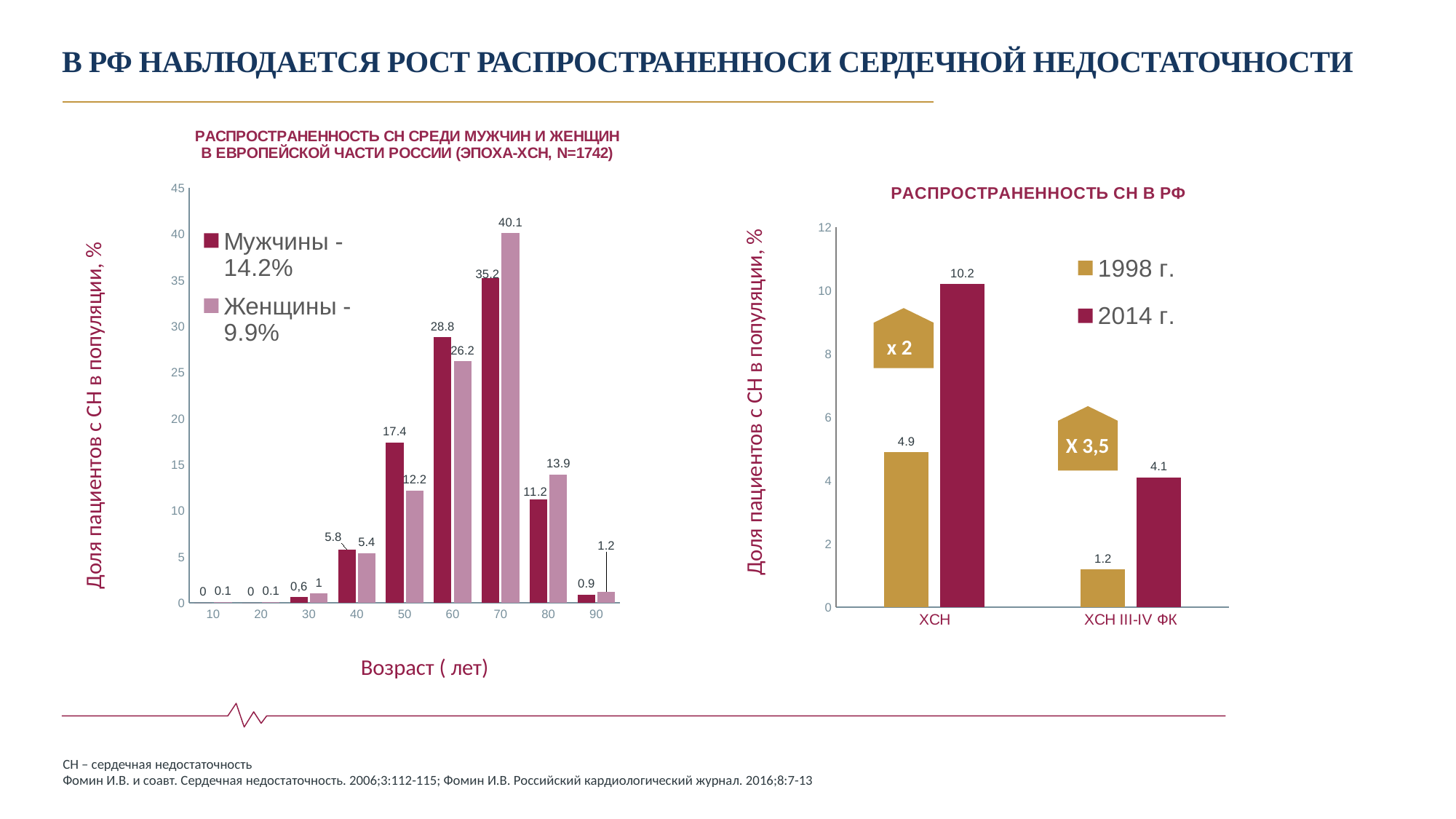
In the left chart (РАСПРОСТРАНЕННОСТЬ СН СРЕДИ МУЖЧИН И ЖЕНЩИН), at which age is the value for Мужчины highest? 70 In the left chart (РАСПРОСТРАНЕННОСТЬ СН СРЕДИ МУЖЧИН И ЖЕНЩИН), how many series does the legend list? 2 In the right chart (РАСПРОСТРАНЕННОСТЬ СН В РФ), what is the value for 1998 г. in the ХСН III-IV ФК category? 1.2 In the left chart (РАСПРОСТРАНЕННОСТЬ СН СРЕДИ МУЖЧИН И ЖЕНЩИН), what is the x-axis title? Возраст ( лет) In the left chart (РАСПРОСТРАНЕННОСТЬ СН СРЕДИ МУЖЧИН И ЖЕНЩИН), which is larger at age 50: Мужчины or Женщины? Мужчины In the left chart (РАСПРОСТРАНЕННОСТЬ СН СРЕДИ МУЖЧИН И ЖЕНЩИН), how many age categories are shown on the x axis? 9 In the left chart (РАСПРОСТРАНЕННОСТЬ СН СРЕДИ МУЖЧИН И ЖЕНЩИН), what is the value for Женщины at age 70? 40.1 In the right chart (РАСПРОСТРАНЕННОСТЬ СН В РФ), what is the value for 2014 г. in the ХСН category? 10.2 In the left chart (РАСПРОСТРАНЕННОСТЬ СН СРЕДИ МУЖЧИН И ЖЕНЩИН), what is the value for Мужчины at age 60? 28.8 What kind of chart is the right chart (РАСПРОСТРАНЕННОСТЬ СН В РФ)? Bar chart In the right chart (РАСПРОСТРАНЕННОСТЬ СН В РФ), what is the difference between 2014 г. and 1998 г. in the ХСН category? 5.3 In the left chart (РАСПРОСТРАНЕННОСТЬ СН СРЕДИ МУЖЧИН И ЖЕНЩИН), what is the difference between Женщины and Мужчины at age 70? 4.9